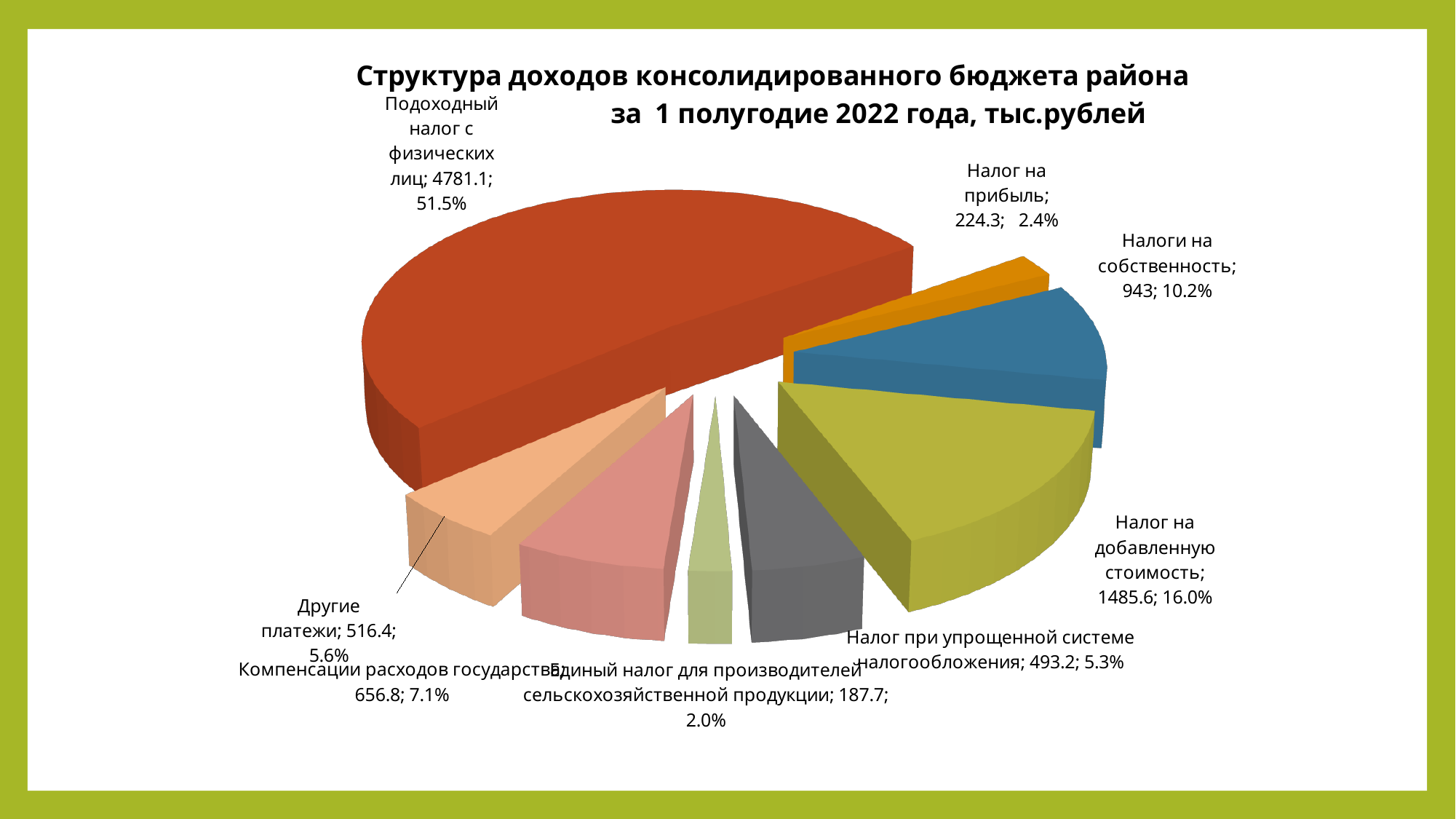
What is the value for Подоходный налог с физических лиц? 4781.1 What share of the pie does Налог на добавленную стоимость represent? 16.0% How many categories are shown in the pie chart? 8 What is the difference between the values for Налог на добавленную стоимость and Налоги на собственность? 542.6 What share of the pie does Налоги на собственность represent? 10.2% What is the title of the chart? Структура доходов консолидированного бюджета района за 1 полугодие 2022 года, тыс.рублей What kind of chart is shown on the slide? Pie chart What is the value for Налог на прибыль? 224.3 What is the difference between the values for Налоги на собственность and Налог на прибыль? 718.7 Which is larger: Другие платежи or Налог при упрощенной системе налогообложения? Другие платежи Which category has the smallest slice of the pie? Единый налог для производителей сельскохозяйственной продукции Which category has the largest slice of the pie? Подоходный налог с физических лиц